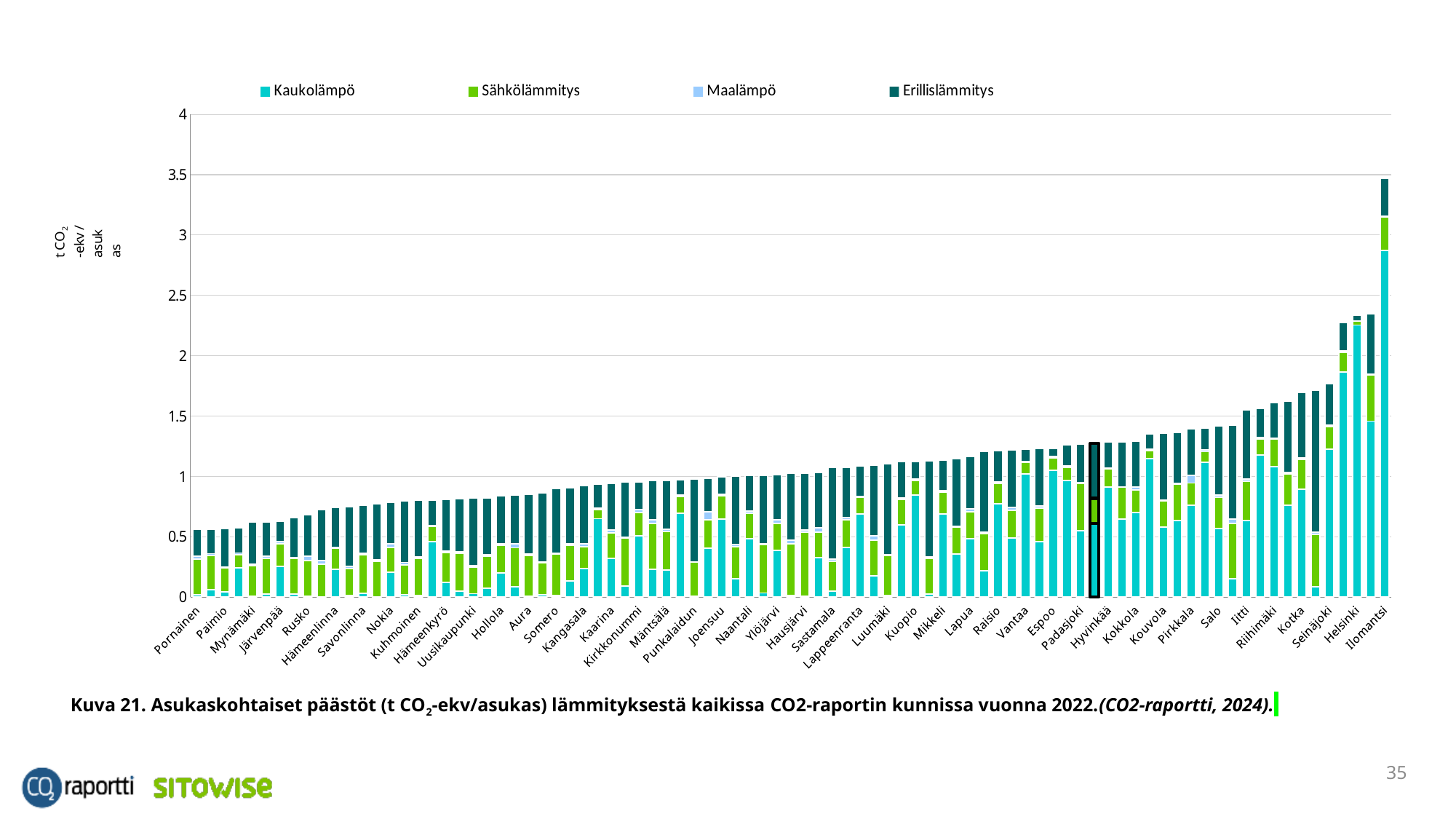
Is the total value for Pornainen greater or less than 1? less How many series does the legend list? 4 Do the total bar heights rise or fall from left to right along the x axis? rise Is the total value for Vantaa greater or less than 1.5? less What kind of chart is shown on the slide? Stacked bar chart Is the total value for Seinäjoki greater or less than 1.5? greater Which municipality has the highest total emissions per inhabitant in the chart? Ilomantsi Which series makes up the largest part of the Ilomantsi bar? Kaukolämpö Which series is listed first in the legend? Kaukolämpö Which has the larger total value, Ilomantsi or Helsinki? Ilomantsi